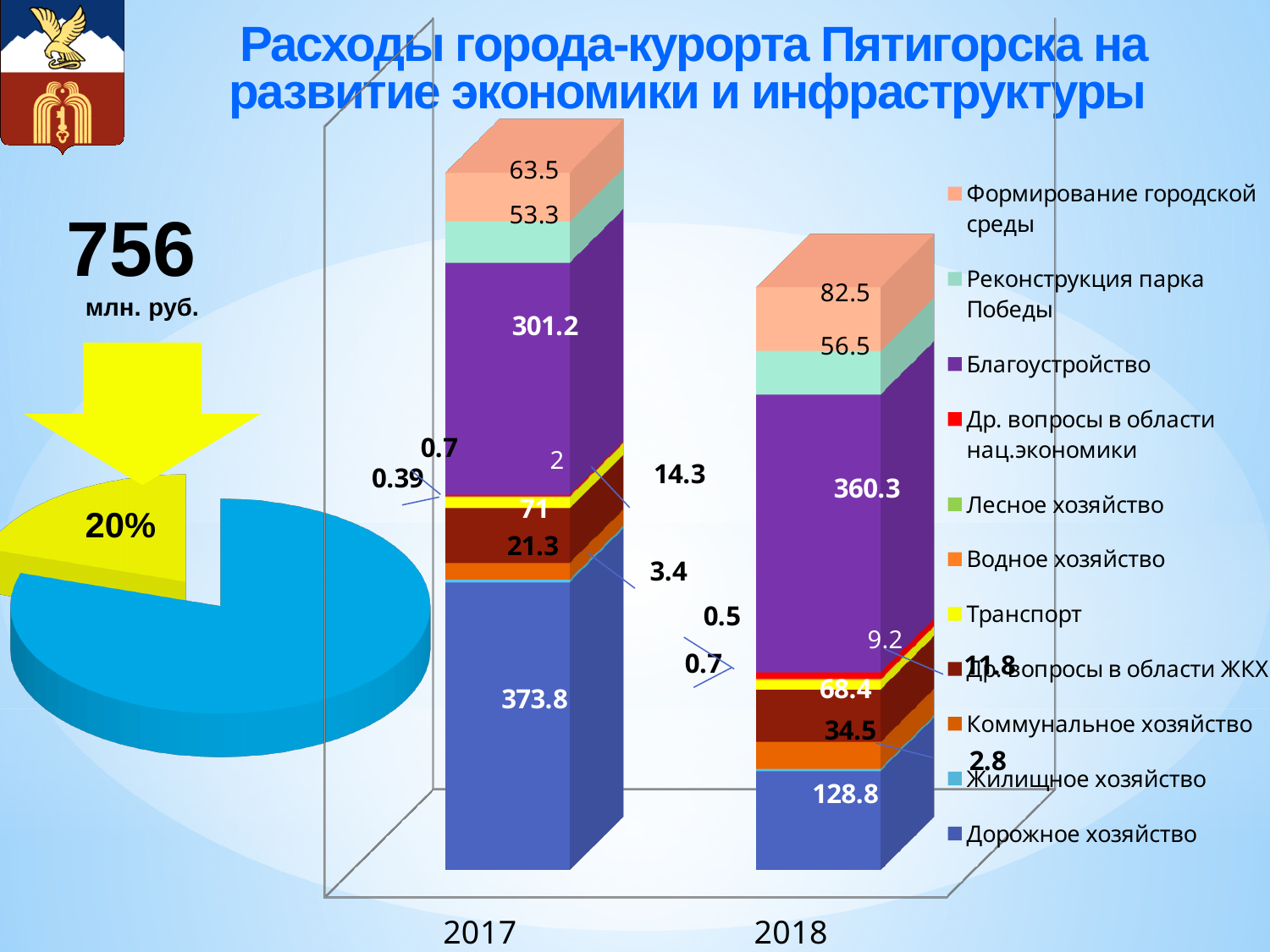
What is the value for Формирование городской среды in 2018? 82.5 How many series does the legend of the stacked bar chart list? 11 Which series has the largest segment in the 2018 bar? Благоустройство Which series has the largest segment in the 2017 bar? Дорожное хозяйство How many years (categories) are shown on the x axis of the stacked bar chart? 2 What is the difference between the Благоустройство values for 2018 and 2017? 59.1 What is the value for Благоустройство in 2018? 360.3 What is the value for Дорожное хозяйство in 2017? 373.8 What type of chart is shown on the slide (the main chart with years on the x axis)? Stacked bar chart Which year has the larger value for Дорожное хозяйство, 2017 or 2018? 2017 Does the value for Формирование городской среды rise or fall from 2017 to 2018? Rise What is the value for Реконструкция парка Победы in 2017? 53.3